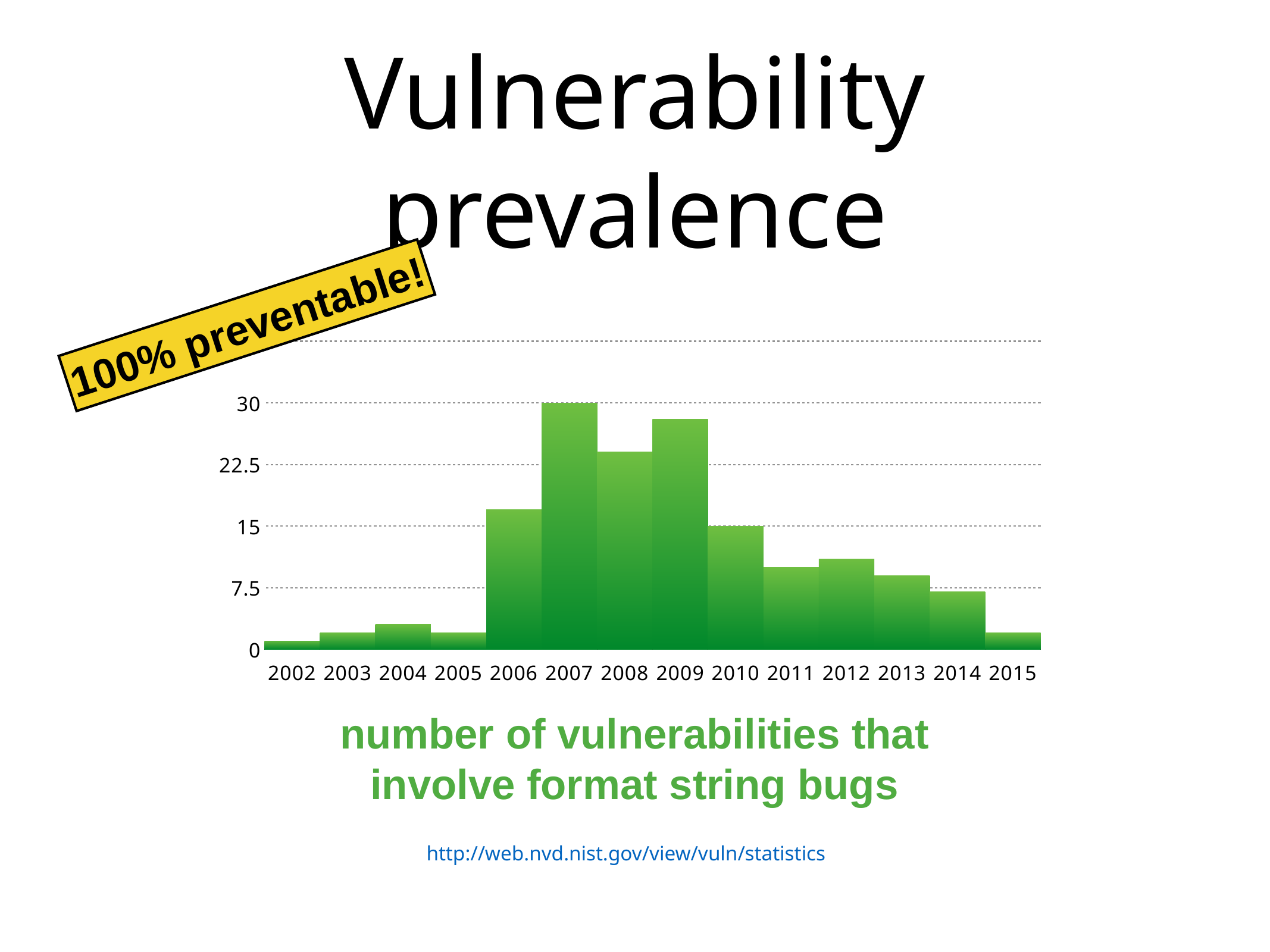
What kind of chart is shown on the slide? bar chart What is the value for 2007? 30 Is the value for 2009 greater or less than 22.5? greater Which year has the highest number of vulnerabilities? 2007 Is the value for 2011 greater or less than 7.5? greater Do the values rise or fall from 2012 to 2015? fall How many years are shown on the x axis? 14 Which is larger, the value for 2007 or the value for 2008? 2007 What is the value for 2010? 15 Which year has the lowest number of vulnerabilities? 2002 Is the value for 2006 greater or less than 15? greater